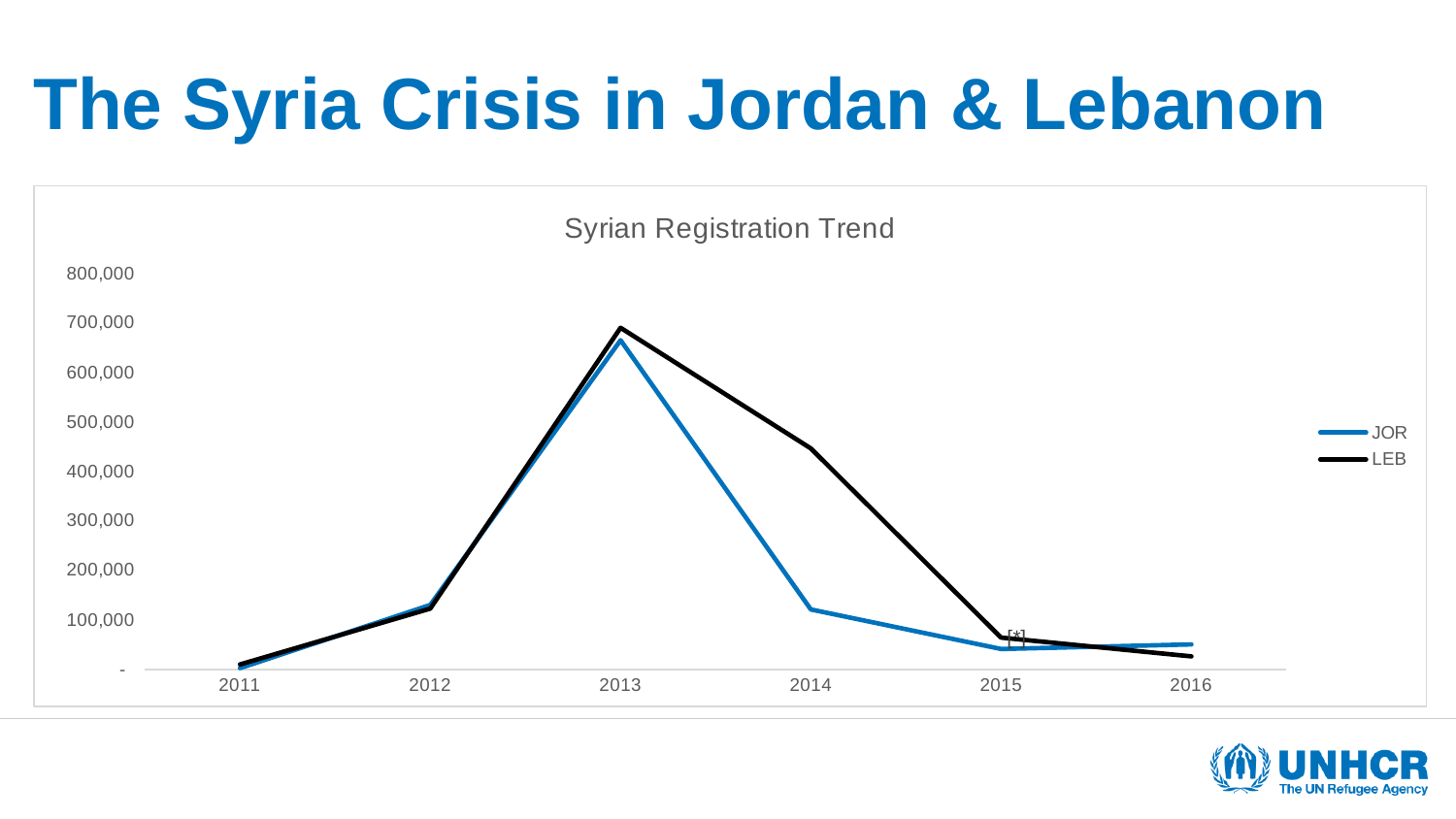
In 2014, which series has the larger value, JOR or LEB? LEB Is the value for JOR in 2014 greater or less than 200,000? less Is the value for LEB in 2014 greater or less than 400,000? greater In which year does the LEB series reach its highest value? 2013 In which year does the JOR series reach its highest value? 2013 What is the title of the chart? Syrian Registration Trend In 2016, which series has the larger value, JOR or LEB? JOR Is the value for LEB in 2013 greater or less than 600,000? greater What kind of chart is shown on the slide? Line chart Does the JOR series rise or fall from 2013 to 2015? fall How many series does the legend list? 2 How many years are shown on the x axis? 6